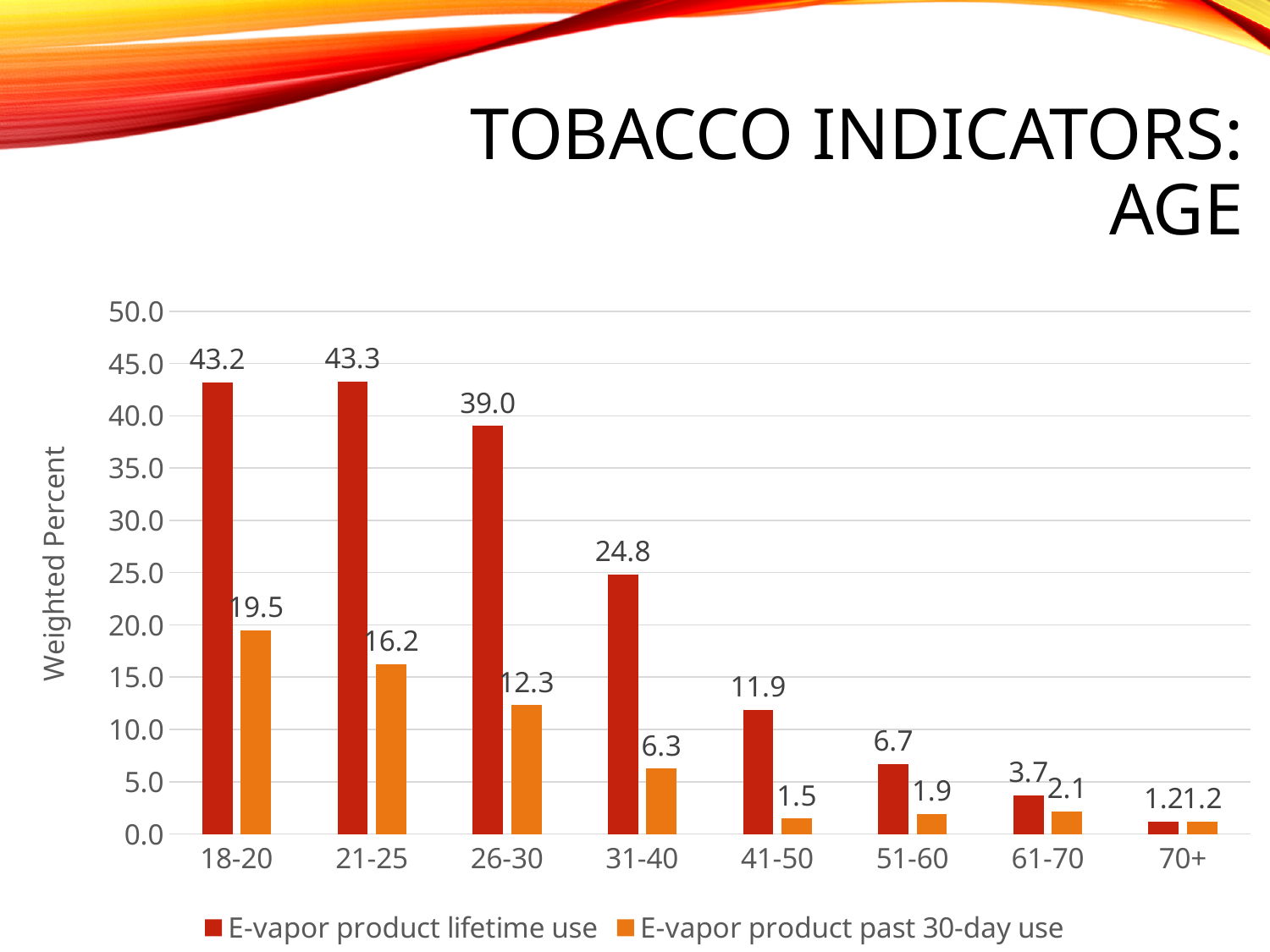
What is the E-vapor product lifetime use value for the 26-30 age group? 39.0 What is the E-vapor product lifetime use value for the 41-50 age group? 11.9 What is the difference between E-vapor product lifetime use and past 30-day use for the 18-20 age group? 23.7 How many age groups are shown on the x axis? 8 What is the label of the y axis? Weighted Percent What is the E-vapor product past 30-day use value for the 31-40 age group? 6.3 Which age group has the lowest E-vapor product lifetime use? 70+ What type of chart is shown on the slide? bar chart Is the E-vapor product lifetime use value for the 31-40 age group greater or less than 20.0? greater Which is larger for the 61-70 age group: E-vapor product lifetime use or past 30-day use? E-vapor product lifetime use How many series does the legend list? 2 Which age group has the highest E-vapor product past 30-day use? 18-20